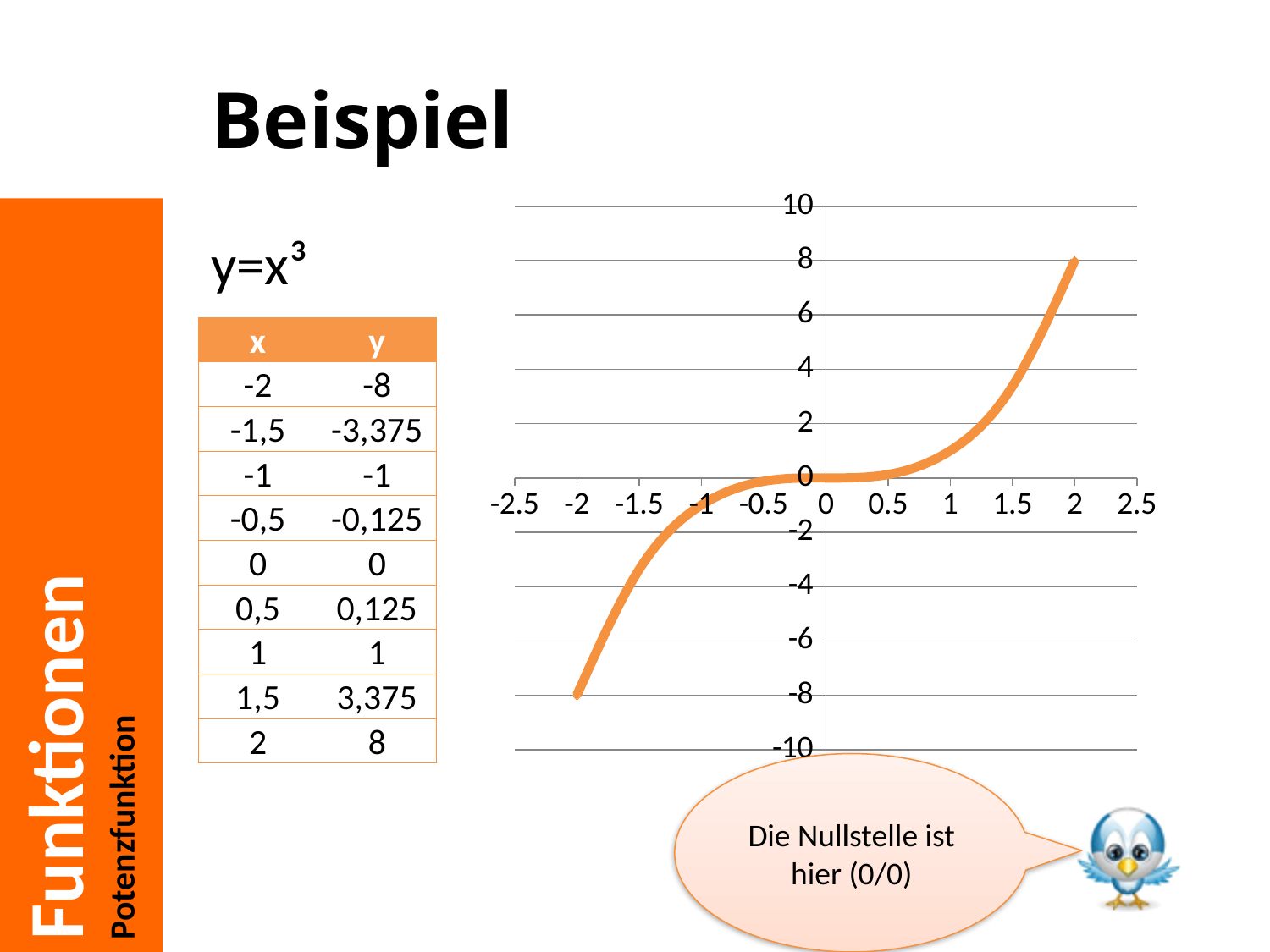
At which x value does the curve reach its highest y value? 2 According to the table, what is the y value when x = 0,5? 0,125 What kind of chart is shown on the slide? line chart According to the table, what is the y value when x = 2? 8 What is the difference between the y values at x = 2 and x = -2? 16 Is the y value at x = -1,5 greater or less than -2? less According to the table, what is the y value when x = -1,5? -3,375 Does the curve rise or fall as x increases from -2 to 2? rises What function is plotted in the chart? y=x³ How many x values are listed in the table of plotted points? 9 Is the y value at x = 1,5 greater or less than 2? greater At which x value does the curve reach its lowest y value? -2